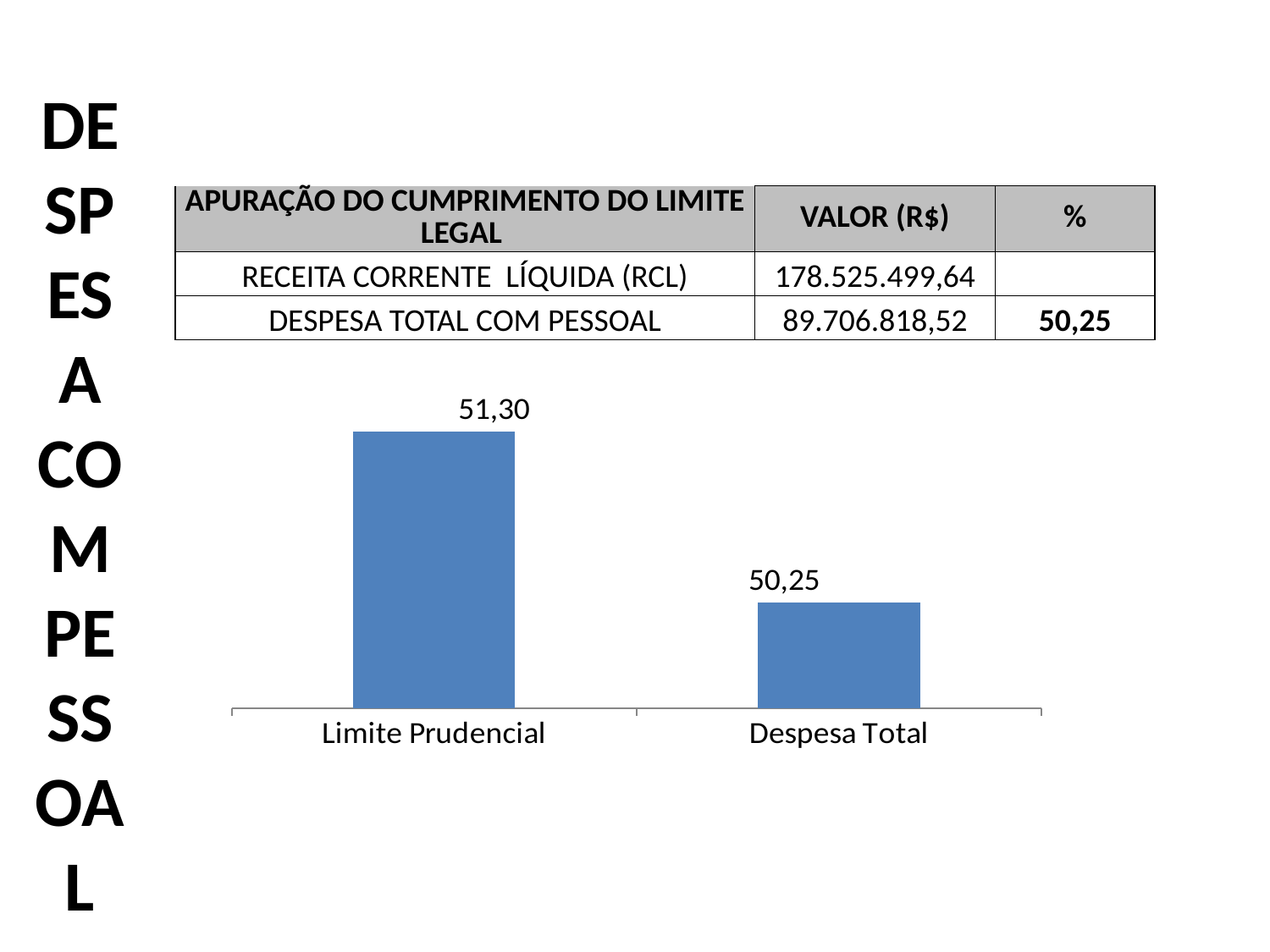
Which category has the lowest value in the bar chart? Despesa Total Do the values in the bar chart rise or fall from left to right along the x axis? Fall What colour are the bars in the bar chart? Blue What are the two category labels on the x axis of the bar chart? Limite Prudencial and Despesa Total Which category has the highest value in the bar chart? Limite Prudencial What is the value shown for Limite Prudencial in the bar chart? 51,30 What is the difference between the values for Limite Prudencial and Despesa Total in the bar chart? 1,05 What is the value shown for Despesa Total in the bar chart? 50,25 What kind of chart is shown on the slide? Bar chart How many categories are shown in the bar chart? 2 Which is larger in the bar chart: Limite Prudencial or Despesa Total? Limite Prudencial